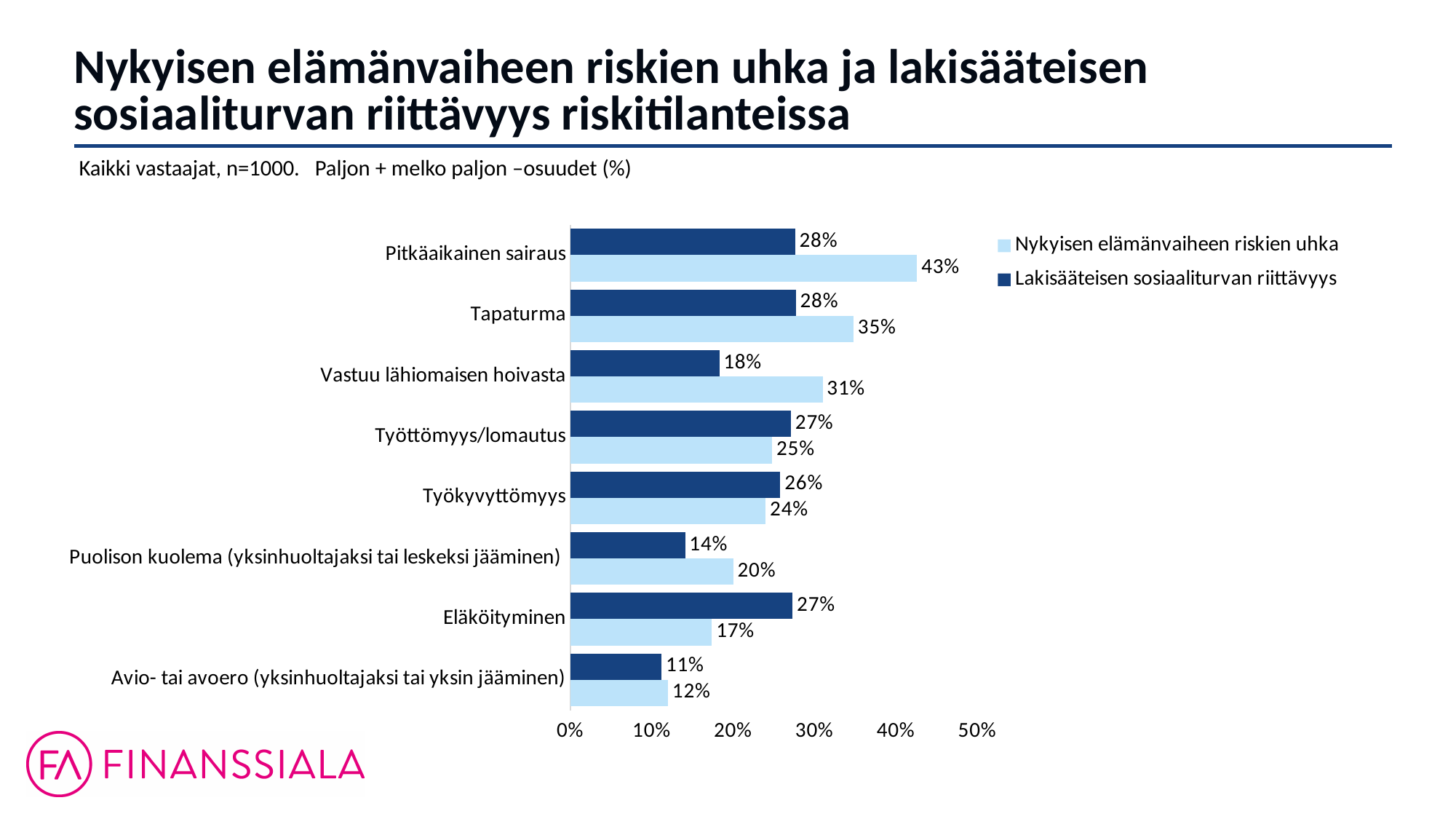
What is the sample size stated in the subtitle of the slide? n=1000 Is the value for "Nykyisen elämänvaiheen riskien uhka" for Tapaturma greater or less than 30%? greater How many series does the legend list? 2 Which category has the highest value for "Nykyisen elämänvaiheen riskien uhka"? Pitkäaikainen sairaus Which category has the lowest value for "Lakisääteisen sosiaaliturvan riittävyys"? Avio- tai avoero (yksinhuoltajaksi tai yksin jääminen) For Eläköityminen, which series has the larger value? Lakisääteisen sosiaaliturvan riittävyys How many categories are shown on the chart? 8 What is the value for "Lakisääteisen sosiaaliturvan riittävyys" for Vastuu lähiomaisen hoivasta? 18% What is the value for "Nykyisen elämänvaiheen riskien uhka" for Eläköityminen? 17% What kind of chart is shown on the slide? Bar chart What is the difference between the two series' values for Pitkäaikainen sairaus? 15 percentage points What is the value for "Nykyisen elämänvaiheen riskien uhka" for Pitkäaikainen sairaus? 43%